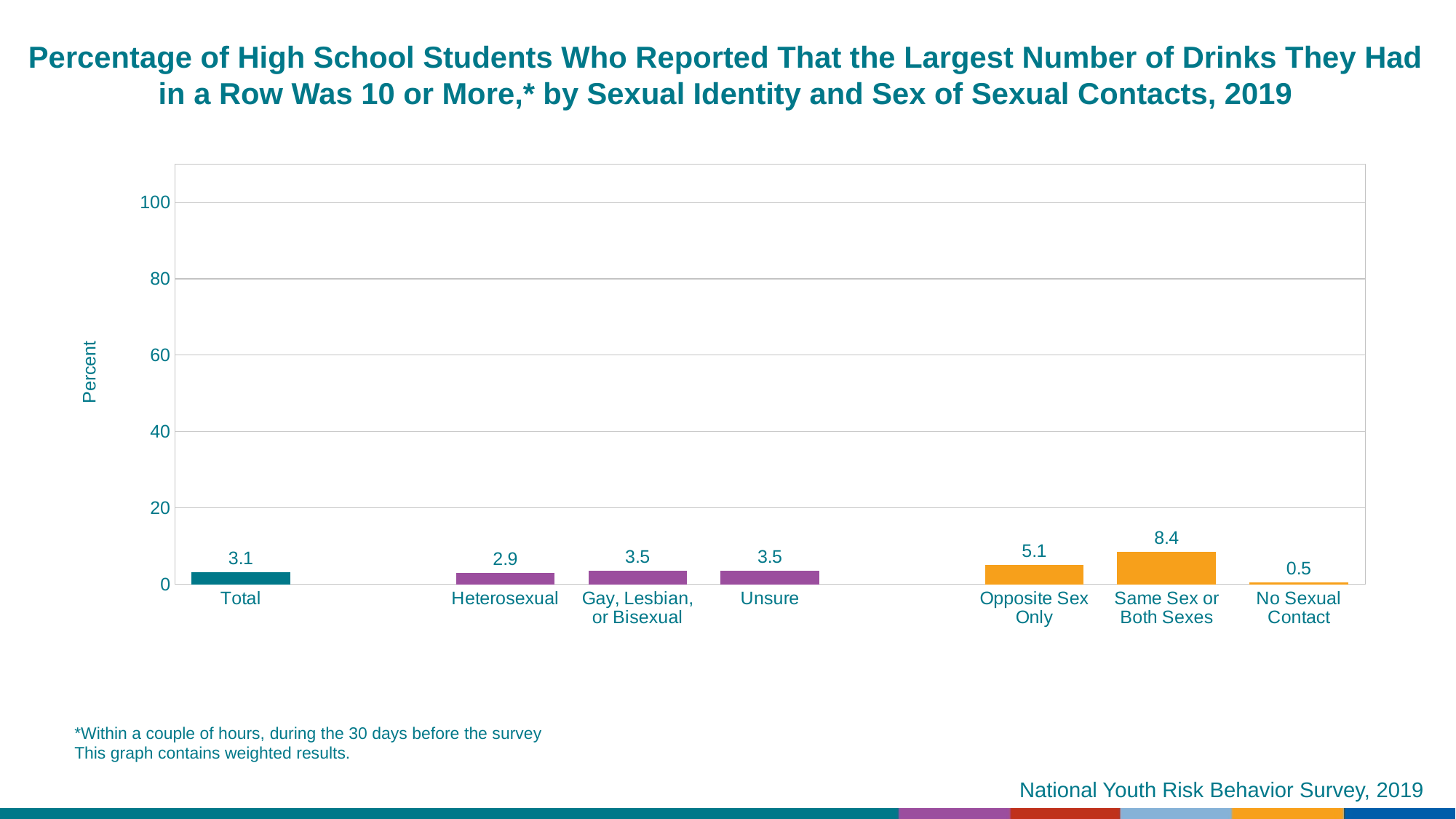
What is the value for Total? 3.1 What is the difference between the values for Same Sex or Both Sexes and Opposite Sex Only? 3.3 What is the value for No Sexual Contact? 0.5 Which category has the highest value? Same Sex or Both Sexes Which is larger, the value for Gay, Lesbian, or Bisexual or the value for Heterosexual? Gay, Lesbian, or Bisexual How many categories are shown on the x axis? 7 Which category has the lowest value? No Sexual Contact What is the label of the y axis? Percent What is the value for Heterosexual? 2.9 What kind of chart is shown on the slide? bar chart What is the value for Same Sex or Both Sexes? 8.4 Is the value for Same Sex or Both Sexes greater or less than 20? less